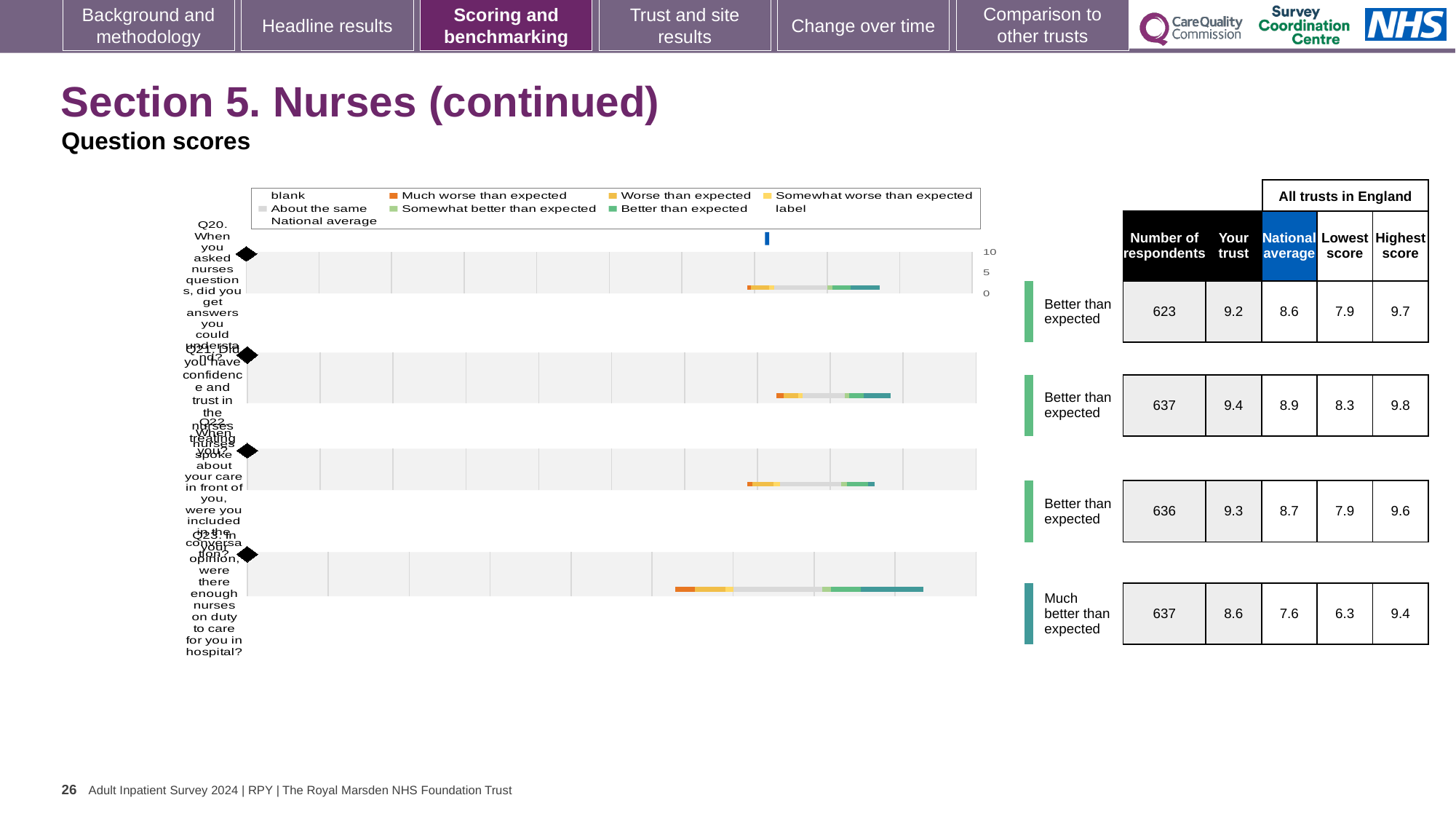
In the table beside the chart, what is the 'Your trust' score for Q20? 9.2 In the table beside the chart, which question has the highest 'Your trust' score? Q21 Which legend entry is shown in orange in the chart? Much worse than expected What benchmark category is given for Q23 next to the chart? Much better than expected In the table beside the chart, which question has the lowest 'Your trust' score? Q23 What kind of chart is shown on the slide? bar chart In the table beside the chart, what is the difference between the 'Your trust' score and the national average for Q23? 1.0 How many questions (categories) are plotted in the chart? 4 In the table beside the chart, what is the national average for Q23? 7.6 What is the highest value shown on the chart's axis? 10 In the table beside the chart, how many respondents answered Q21? 637 In the table beside the chart, is the 'Your trust' score for Q22 higher or lower than the national average for Q22? higher